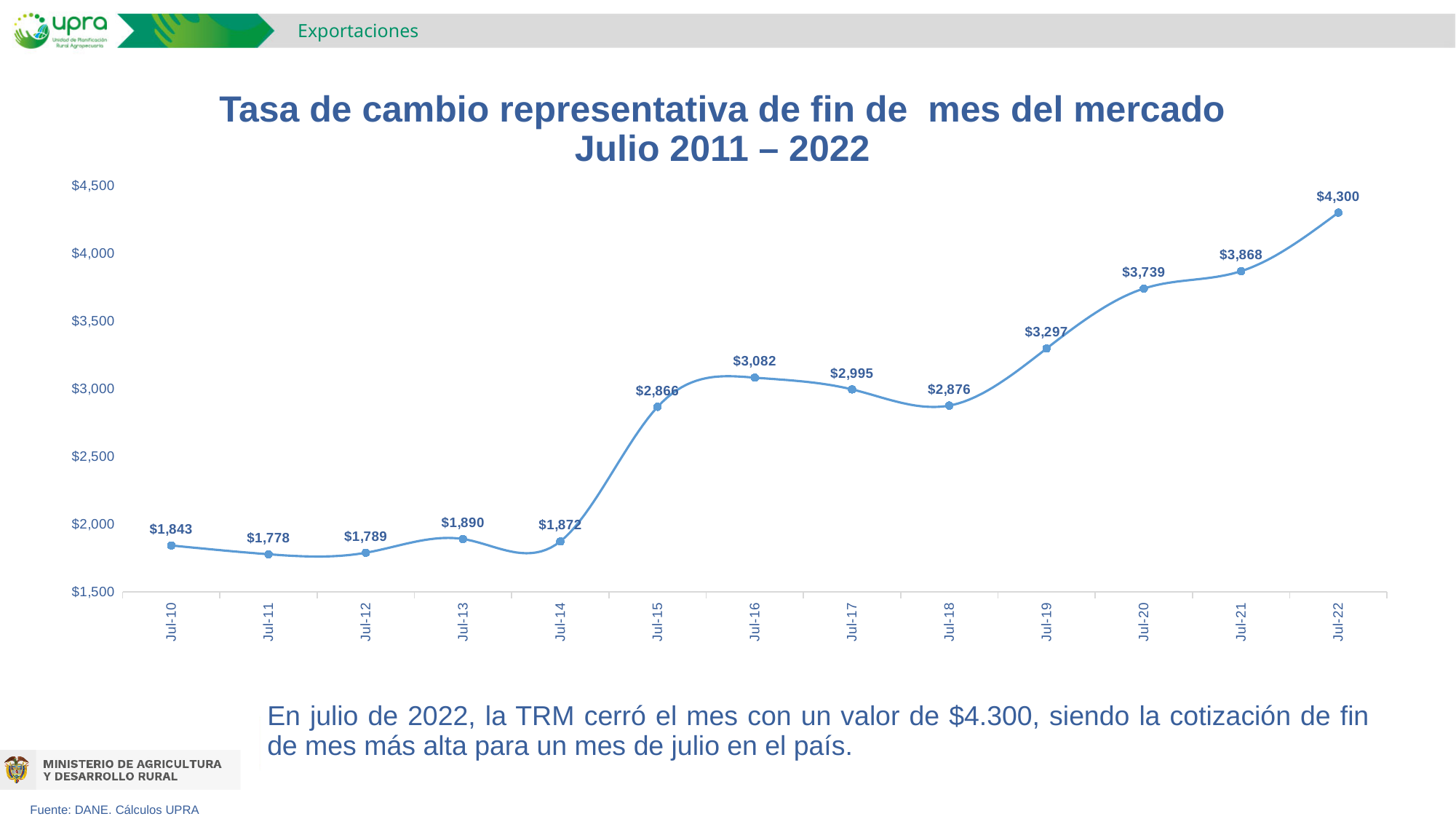
What is the value for Jul-22? $4,300 Is the value for Jul-19 greater or less than $3,000? greater Do the values generally rise or fall from Jul-18 to Jul-22? rise What is the difference between the values for Jul-16 and Jul-17? $87 What is the value for Jul-11? $1,778 How many data points are plotted on the chart? 13 What is the value for Jul-15? $2,866 Which is larger, the value for Jul-16 or the value for Jul-18? Jul-16 What is the difference between the values for Jul-22 and Jul-21? $432 Which point has the lowest value? Jul-11 Which point has the highest value? Jul-22 What kind of chart is shown on the slide? line chart